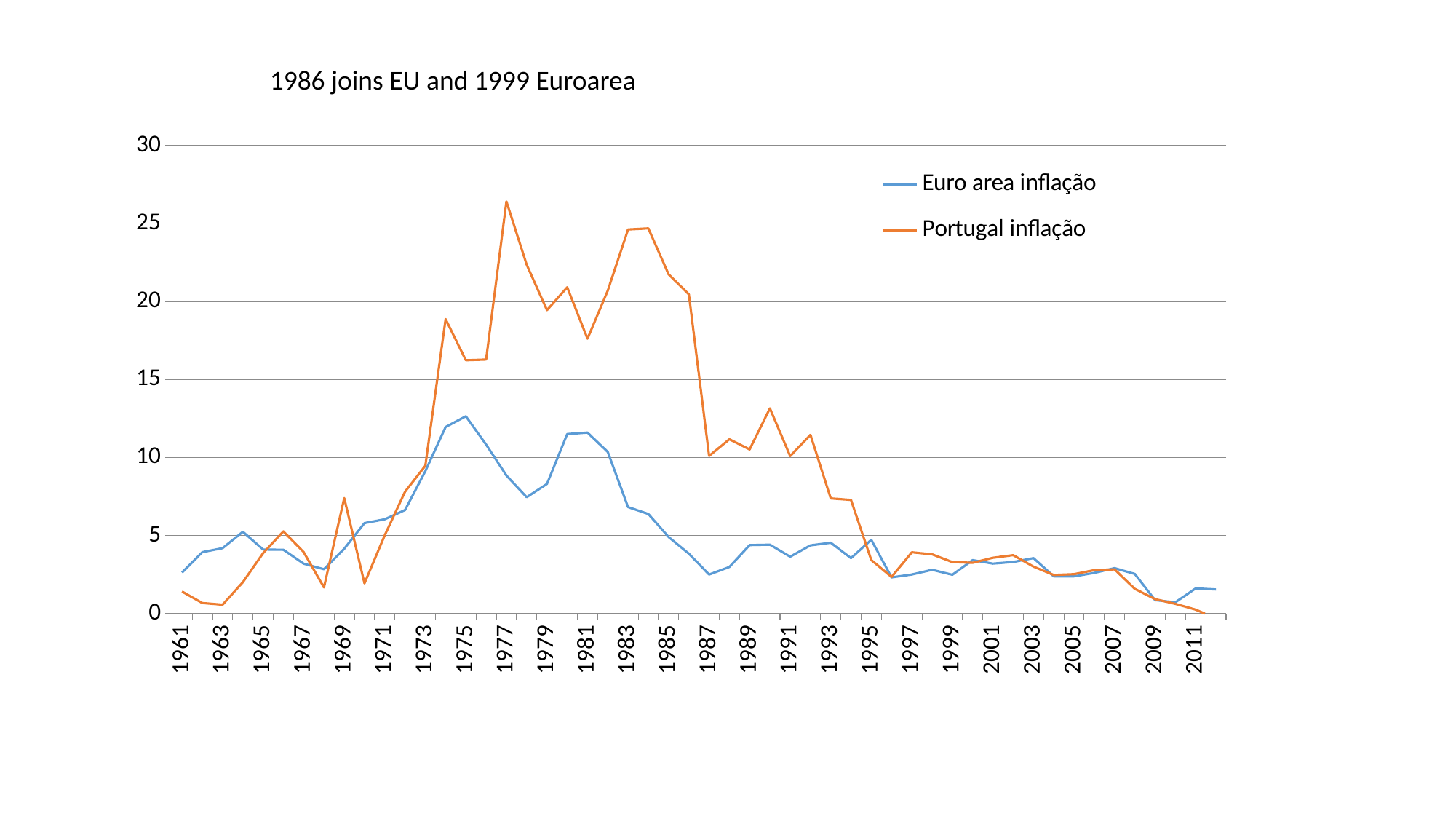
Does the Portugal inflação series generally rise or fall between 1977 and 1997? Fall Is the value for Euro area inflação in 1975 greater or less than 10? greater In 1977, which series has the higher value, Euro area inflação or Portugal inflação? Portugal inflação What is the title of the chart? 1986 joins EU and 1999 Euroarea How many series does the legend list? 2 Is the value for Portugal inflação in 1963 greater or less than 5? less Is the value for Portugal inflação in 1977 greater or less than 25? greater Which series is drawn in orange? Portugal inflação In which year does the Euro area inflação series reach its highest value? 1975 What kind of chart is shown on the slide? Line chart In which year does the Portugal inflação series reach its highest value? 1977